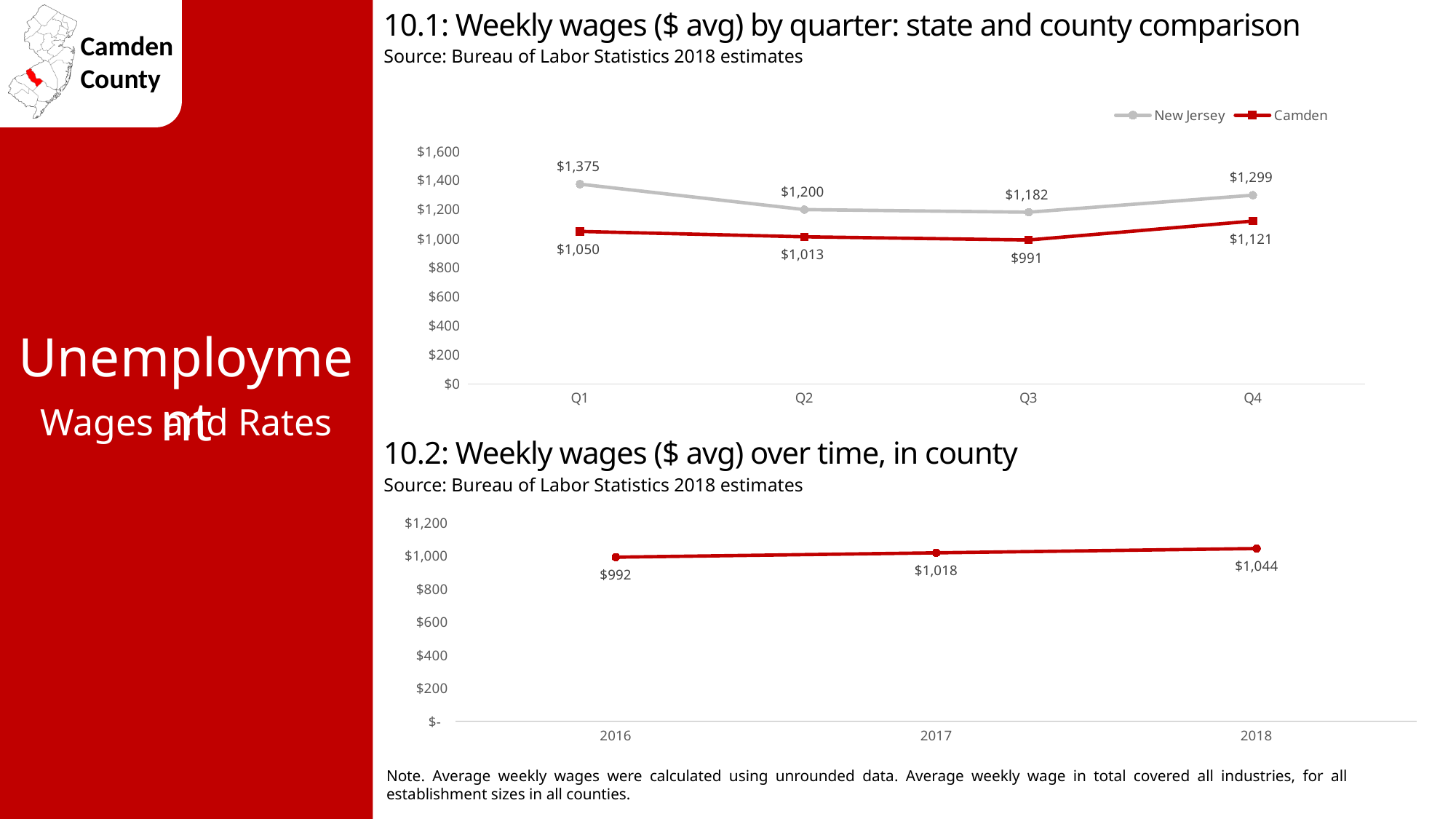
In chart 10.1, what is the difference between the New Jersey and Camden weekly wages in Q4? $178 In chart 10.2, do weekly wages rise or fall from 2016 to 2018? Rise What kind of chart is chart 10.2? Line chart In chart 10.1, which is larger in Q2: the New Jersey wage or the Camden wage? New Jersey In chart 10.1, how many quarters are plotted on the x axis? 4 In chart 10.2, what is the weekly wage in 2017? $1,018 In chart 10.1, what is the New Jersey weekly wage in Q1? $1,375 In chart 10.1, which quarter has the lowest Camden weekly wage? Q3 In chart 10.2, what is the difference between the 2018 and 2016 weekly wages? $52 In chart 10.1, what is the Camden weekly wage in Q3? $991 In chart 10.1, how many series does the legend list? 2 In chart 10.1, which quarter has the highest New Jersey weekly wage? Q1